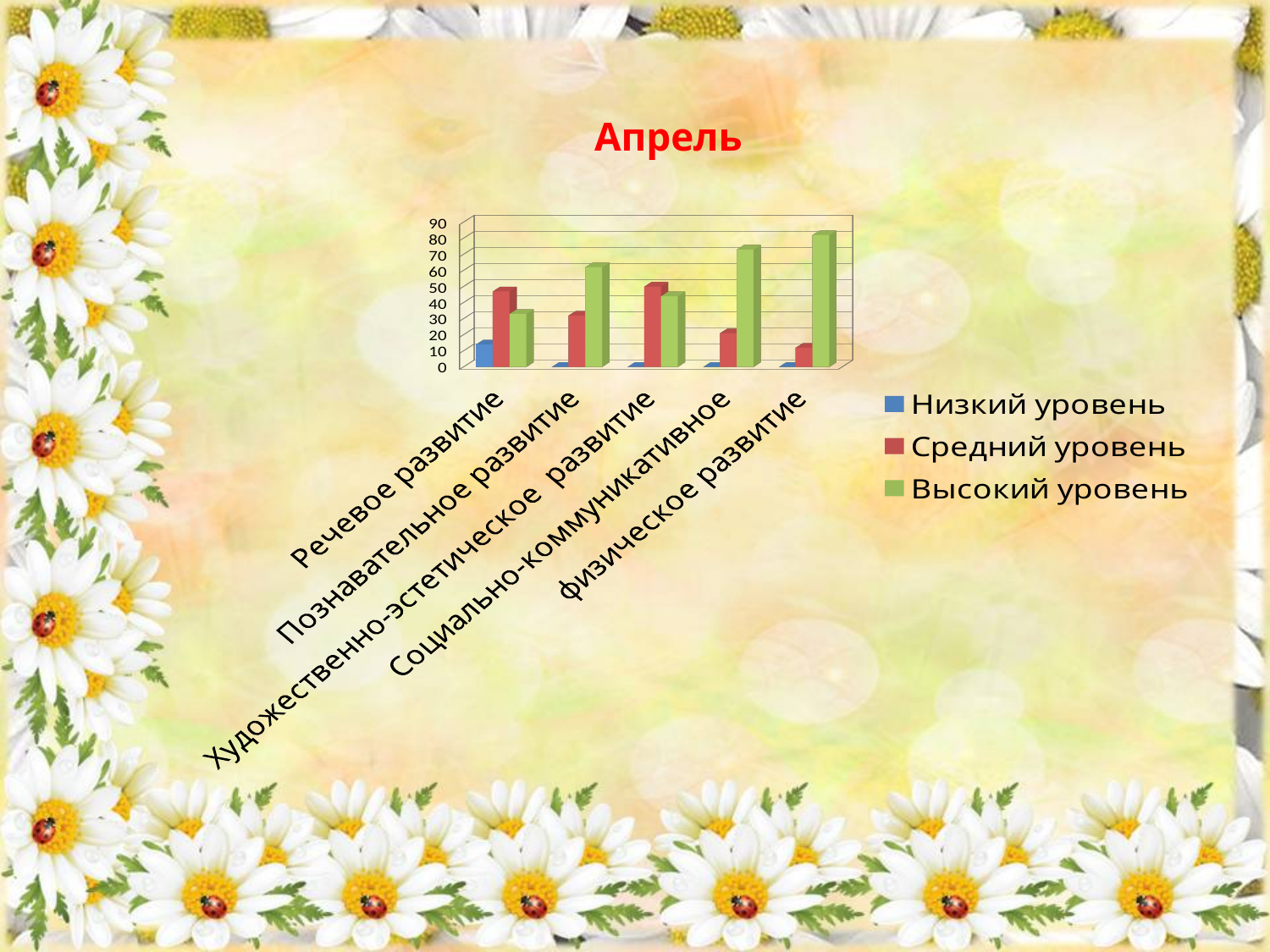
For Познавательное развитие, which is larger: Средний уровень or Высокий уровень? Высокий уровень Which category has the lowest value for Средний уровень? Физическое развитие For Речевое развитие, which is larger: Средний уровень or Высокий уровень? Средний уровень What kind of chart is shown on the slide? bar chart Is the value for Высокий уровень in Социально-коммуникативное greater or less than 60? greater What is the title of the chart? Апрель Which category has the highest value for Высокий уровень? Физическое развитие How many categories are shown on the x axis of the chart? 5 Is the value for Средний уровень in Физическое развитие greater or less than 20? less Is the value for Высокий уровень in Физическое развитие greater or less than 70? greater How many series does the legend list? 3 Which series is shown in green in the legend? Высокий уровень